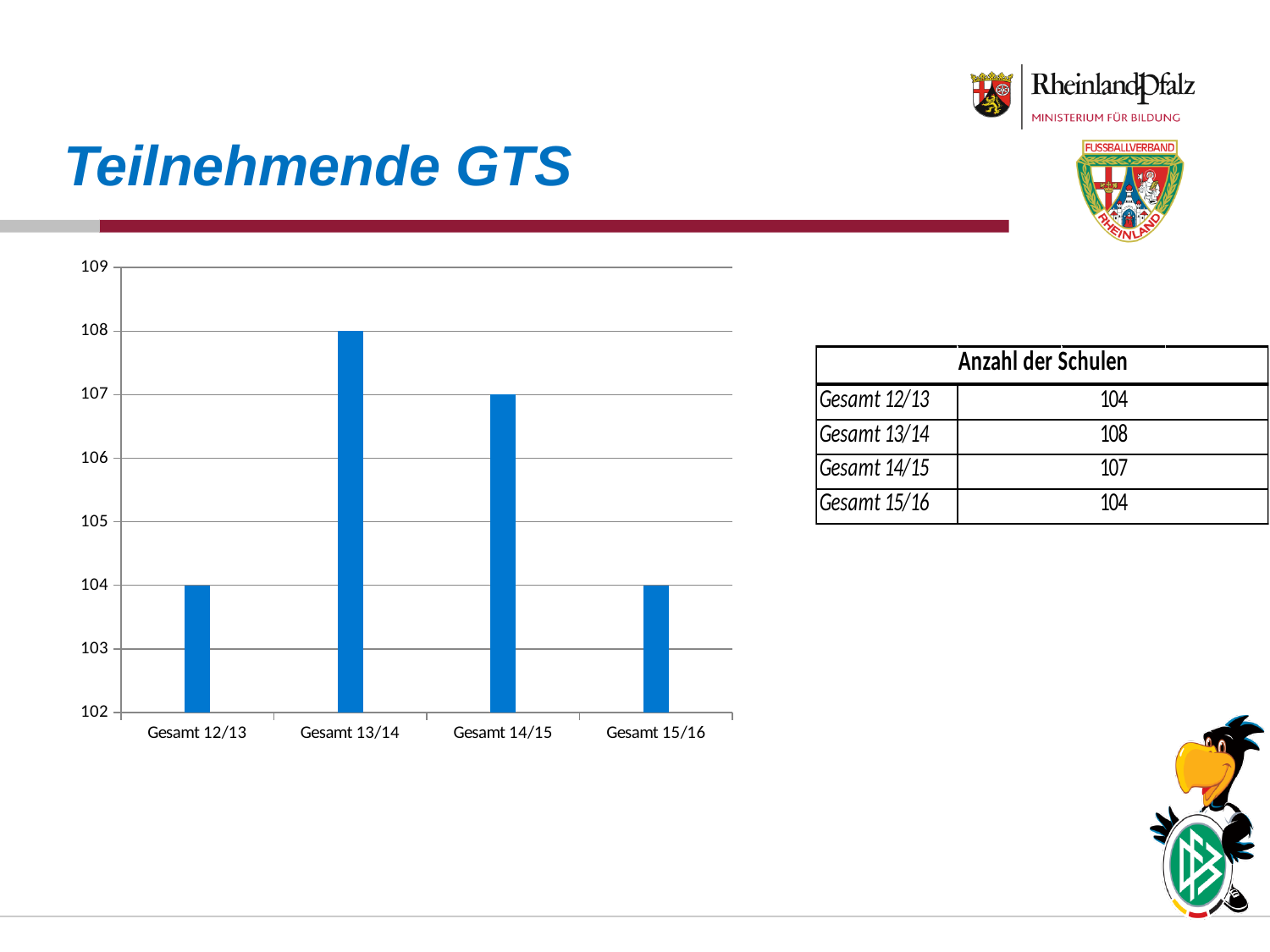
What is the value for Gesamt 15/16? 104 Does the value rise or fall from Gesamt 14/15 to Gesamt 15/16? fall What kind of chart is shown on the slide? bar chart Which category has the highest value? Gesamt 13/14 What is the difference between the values for Gesamt 13/14 and Gesamt 12/13? 4 Is the value for Gesamt 13/14 greater or less than 106? greater What is the value for Gesamt 12/13? 104 Which is larger, the value for Gesamt 13/14 or the value for Gesamt 14/15? Gesamt 13/14 What is the value for Gesamt 14/15? 107 How many categories are shown on the x axis? 4 What is the difference between the values for Gesamt 14/15 and Gesamt 15/16? 3 What is the value for Gesamt 13/14? 108